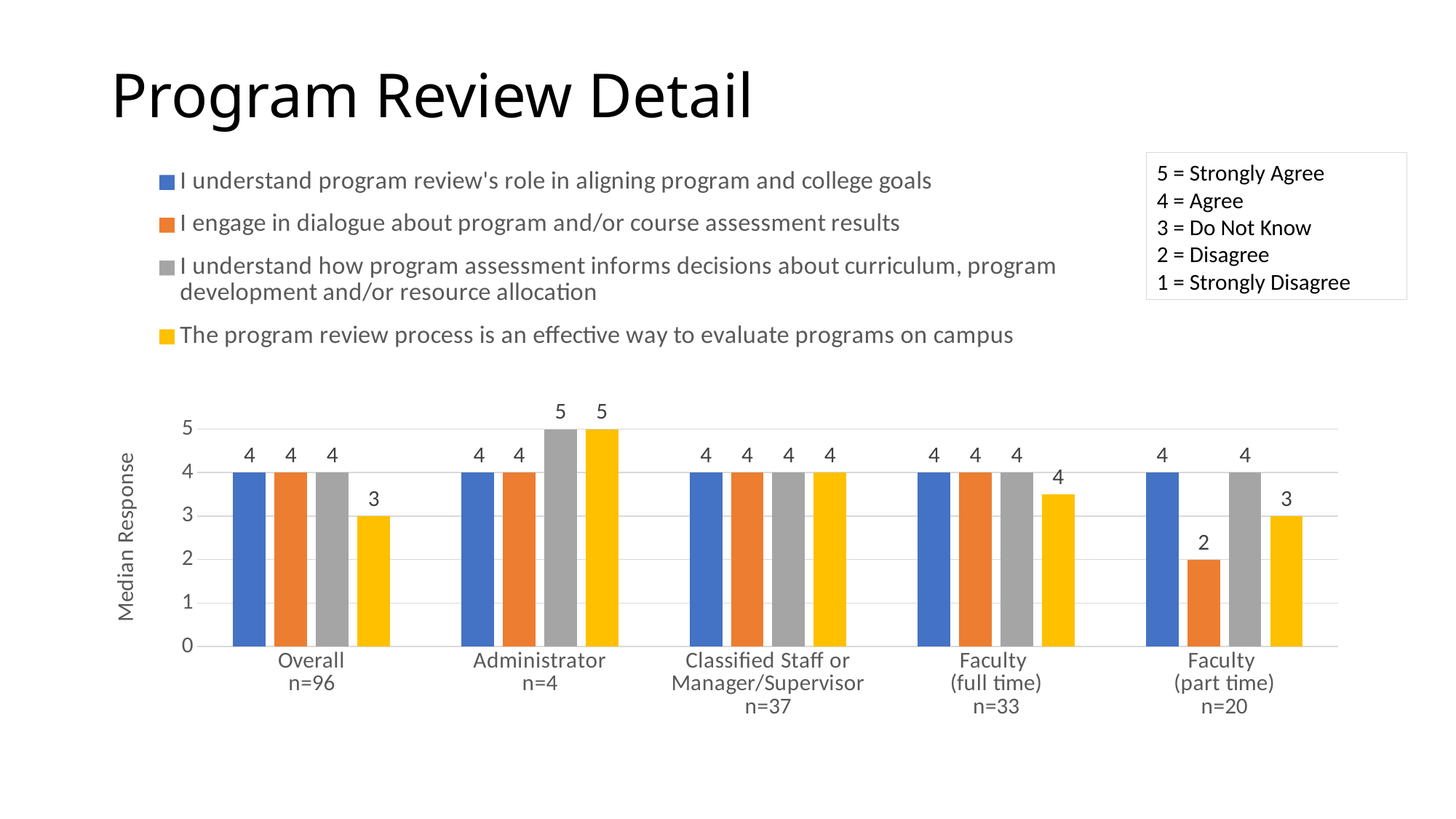
What is the sample size (n) shown for the Classified Staff or Manager/Supervisor group? n=37 What type of chart is shown on the slide? bar chart Which is larger: the Faculty (part time) median for 'I understand program review's role in aligning program and college goals' or for 'I engage in dialogue about program and/or course assessment results'? I understand program review's role in aligning program and college goals What is the median response for 'The program review process is an effective way to evaluate programs on campus' in the Overall group? 3 What is the y-axis title of the chart? Median Response Which respondent group has the highest median response for 'The program review process is an effective way to evaluate programs on campus'? Administrator What is the median response for 'I engage in dialogue about program and/or course assessment results' among Faculty (part time)? 2 How many series does the legend list? 4 What is the difference between the Administrator and Overall median responses for 'The program review process is an effective way to evaluate programs on campus'? 2 What is the median response for 'I understand how program assessment informs decisions about curriculum, program development and/or resource allocation' among Administrators? 5 How many respondent groups are shown along the x axis? 5 Which respondent group has the lowest median response for 'I engage in dialogue about program and/or course assessment results'? Faculty (part time)